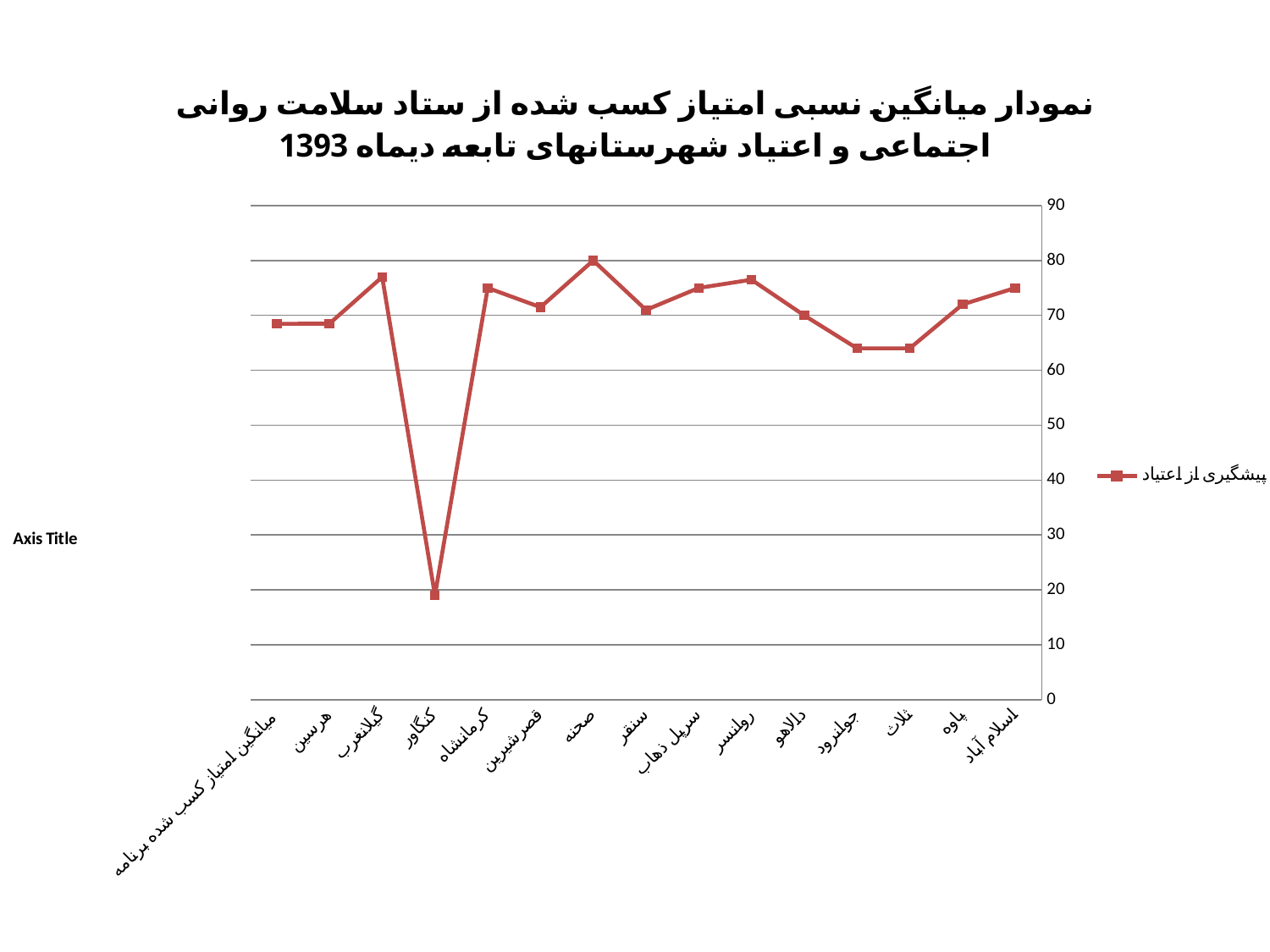
How many series does the legend list? 1 What is the name of the series shown in the legend? پیشگیری از اعتیاد What kind of chart is shown on the slide? line chart Which category has the highest value? صحنه Which has the larger value, گیلانغرب or کنگاور? گیلانغرب How many categories are plotted along the x axis? 15 Which category has the lowest value? کنگاور Is the value for گیلانغرب greater or less than 70? greater Is the value for روانسر greater or less than 70? greater Is the value for جوانرود greater or less than 70? less What is the value for صحنه? 80